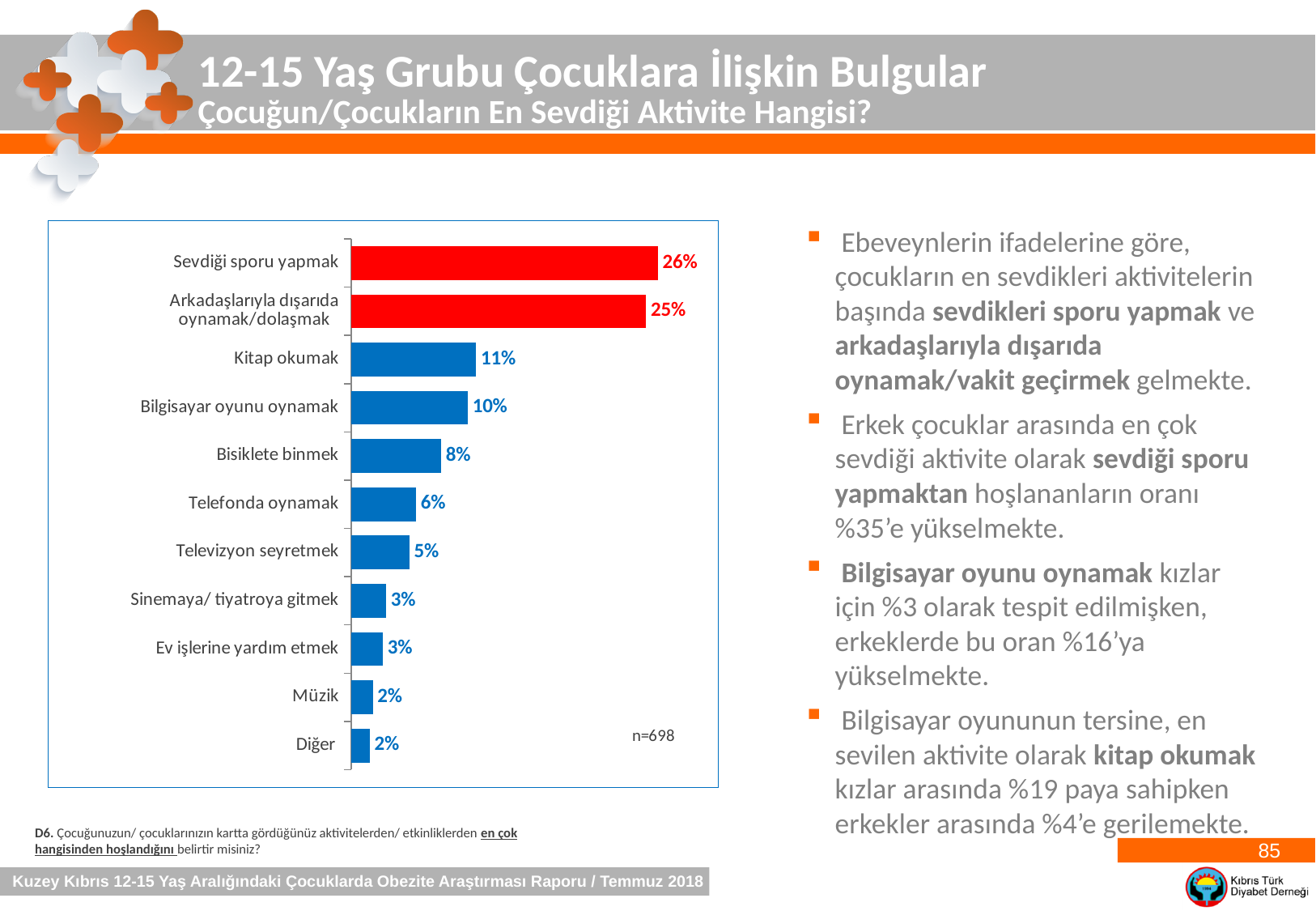
What is the difference between Kitap okumak and Bisiklete binmek? 3% What is the value for Bisiklete binmek? 8% Which two categories are shown with red bars? Sevdiği sporu yapmak and Arkadaşlarıyla dışarıda oynamak/dolaşmak How many categories are shown in the chart? 11 What kind of chart is shown on the slide? Bar chart Which is larger, Telefonda oynamak or Televizyon seyretmek? Telefonda oynamak What is the difference between Sevdiği sporu yapmak and Bilgisayar oyunu oynamak? 16% Which category has the highest value? Sevdiği sporu yapmak What is the value for Sinemaya/ tiyatroya gitmek? 3% What is the value for Arkadaşlarıyla dışarıda oynamak/dolaşmak? 25% What is the value for Kitap okumak? 11% What sample size (n) is shown on the chart? n=698